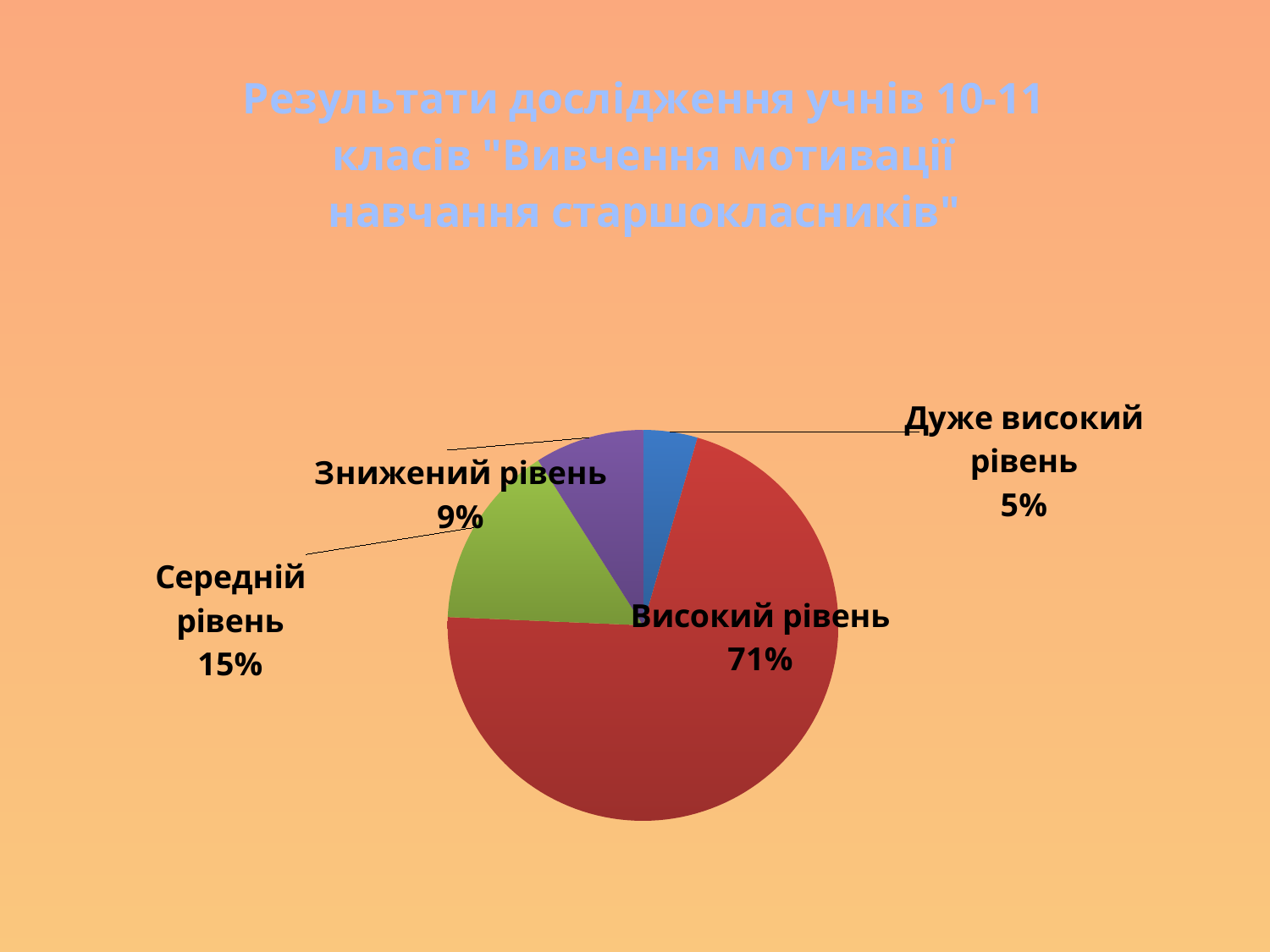
How many slices does the pie chart have? 4 What is the value shown for "Середній рівень"? 15% What is the value shown for "Знижений рівень"? 9% What is the difference between the values for "Середній рівень" and "Знижений рівень"? 6% What is the difference between the values for "Високий рівень" and "Середній рівень"? 56% What share of the pie does "Високий рівень" have? 71% What colour is the slice for "Середній рівень"? green What is the value shown for "Дуже високий рівень"? 5% What kind of chart is shown on the slide? pie chart Which is larger, the value for "Знижений рівень" or the value for "Дуже високий рівень"? Знижений рівень Which category has the largest slice of the pie? Високий рівень Which category has the smallest slice of the pie? Дуже високий рівень